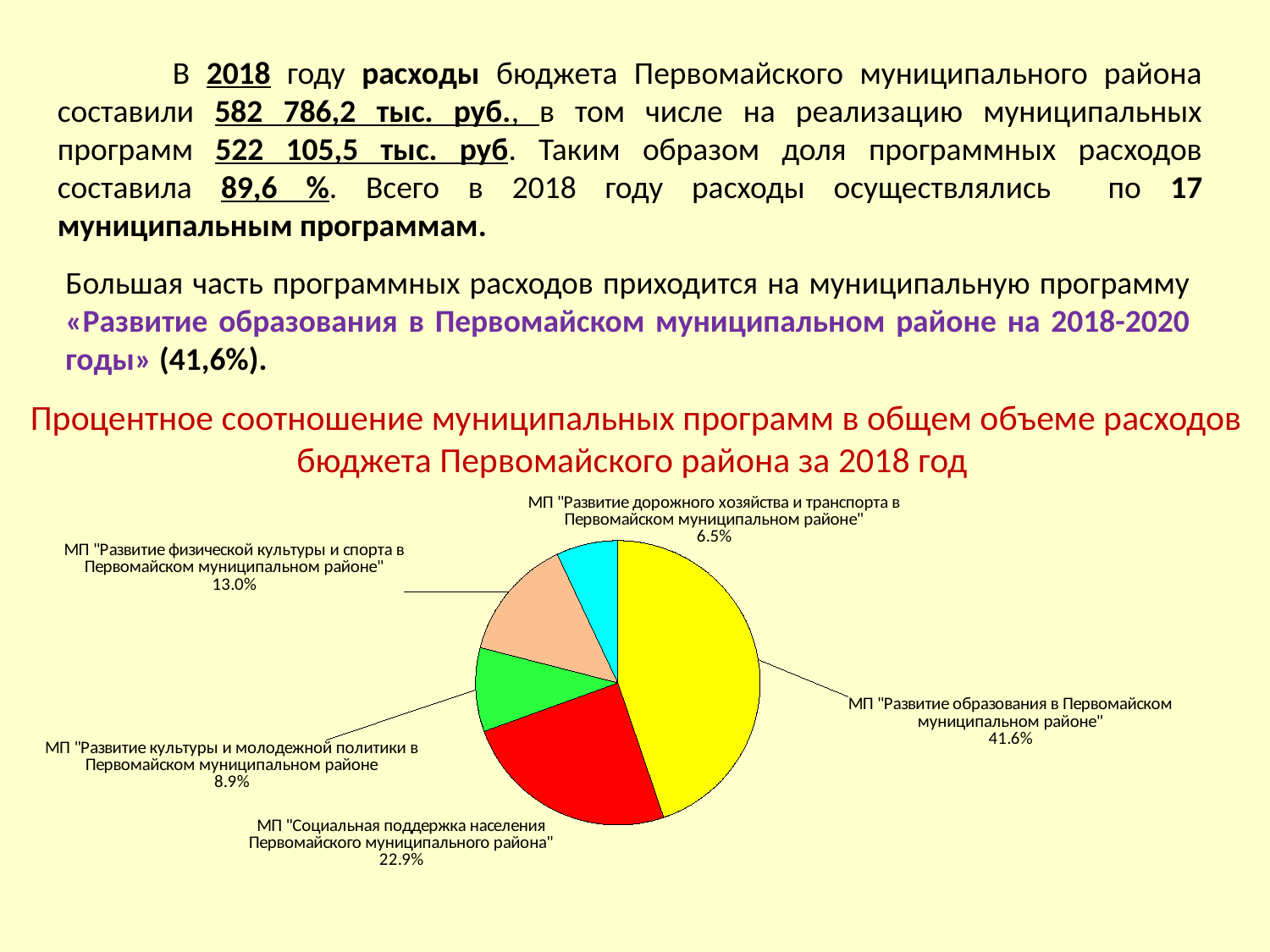
What share of the pie does МП "Развитие образования в Первомайском муниципальном районе" have? 41.6% How many slices does the pie chart have? 5 What share of the pie does МП "Развитие физической культуры и спорта в Первомайском муниципальном районе" have? 13.0% What share of the pie does МП "Социальная поддержка населения Первомайского муниципального района" have? 22.9% What share of the pie does МП "Развитие дорожного хозяйства и транспорта в Первомайском муниципальном районе" have? 6.5% Which municipal programme has the largest slice of the pie? МП "Развитие образования в Первомайском муниципальном районе" What is the difference in percentage points between the education programme slice (41.6%) and the social support programme slice (22.9%)? 18.7 Which slice is larger: МП "Развитие физической культуры и спорта" or МП "Развитие культуры и молодежной политики"? МП "Развитие физической культуры и спорта в Первомайском муниципальном районе" What is the chart's title? Процентное соотношение муниципальных программ в общем объеме расходов бюджета Первомайского района за 2018 год What type of chart is shown on the slide? pie chart What share of the pie does МП "Развитие культуры и молодежной политики в Первомайском муниципальном районе" have? 8.9% Which municipal programme has the smallest slice of the pie? МП "Развитие дорожного хозяйства и транспорта в Первомайском муниципальном районе"